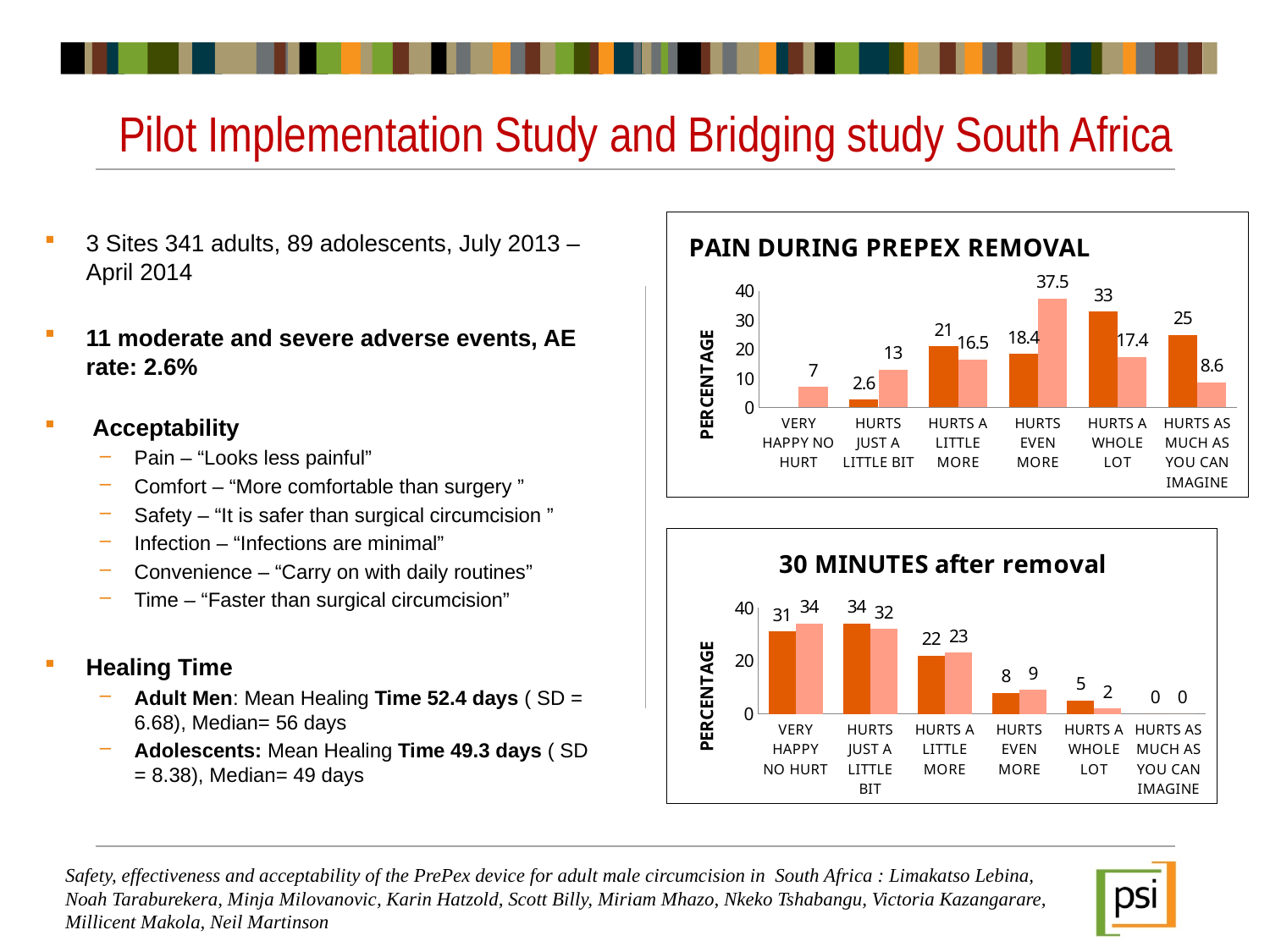
In the '30 MINUTES after removal' chart, what is the value of the light orange bar for 'VERY HAPPY NO HURT'? 34 In the 'PAIN DURING PREPEX REMOVAL' chart, which category has the highest light orange bar? HURTS EVEN MORE In the '30 MINUTES after removal' chart, what is the difference between the dark orange and light orange bars for 'HURTS A WHOLE LOT'? 3 In the 'PAIN DURING PREPEX REMOVAL' chart, what is the value of the dark orange bar for 'HURTS JUST A LITTLE BIT'? 2.6 In the 'PAIN DURING PREPEX REMOVAL' chart, which is larger for 'HURTS A LITTLE MORE': the dark orange bar or the light orange bar? the dark orange bar In the '30 MINUTES after removal' chart, which category has the lowest values for both bars? HURTS AS MUCH AS YOU CAN IMAGINE In the 'PAIN DURING PREPEX REMOVAL' chart, what is the value of the dark orange bar for 'HURTS A WHOLE LOT'? 33 In the 'PAIN DURING PREPEX REMOVAL' chart, what is the difference between the dark orange and light orange bars for 'HURTS AS MUCH AS YOU CAN IMAGINE'? 16.4 In the 'PAIN DURING PREPEX REMOVAL' chart, what is the value of the light orange bar for 'HURTS EVEN MORE'? 37.5 How many categories are shown on the x axis of the '30 MINUTES after removal' chart? 6 What is the y-axis label of the 'PAIN DURING PREPEX REMOVAL' chart? PERCENTAGE What type of chart is the '30 MINUTES after removal' chart? bar chart